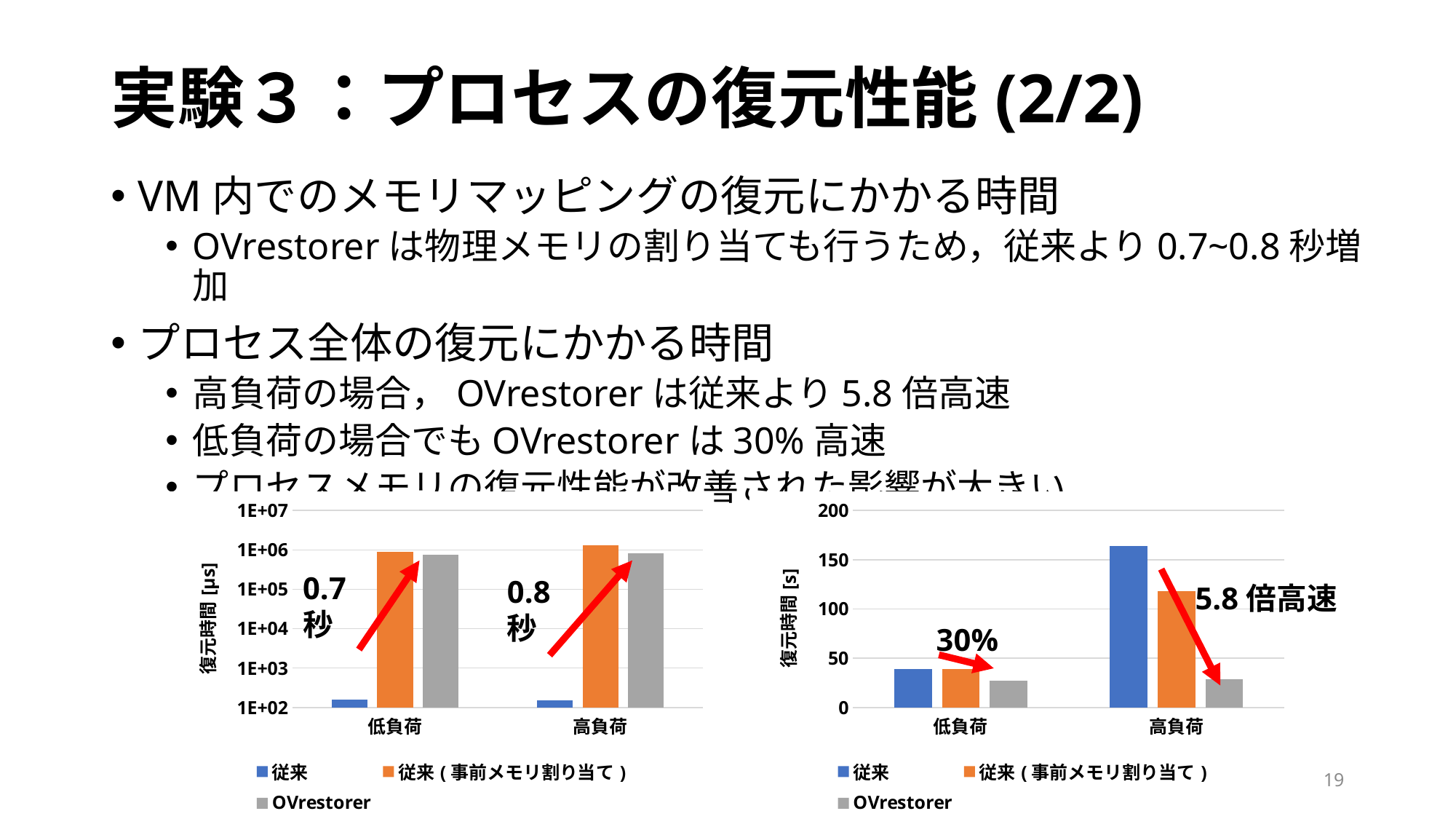
In the right chart (復元時間 [s]), which series has the lowest value at 高負荷? OVrestorer In the left chart (復元時間 [μs]), is the value for 従来 at 低負荷 greater or less than 1E+03? less What kind of chart is the left chart (復元時間 [μs])? bar chart In the right chart (復元時間 [s]), is the value for 従来 at 高負荷 greater or less than 150? greater In the left chart (復元時間 [μs]), which series has the lowest value at 低負荷? 従来 How many categories are shown on the x axis of the right chart (復元時間 [s])? 2 What is the y-axis label of the left chart? 復元時間 [μs] How many series does the legend of the right chart (復元時間 [s]) list? 3 In the right chart (復元時間 [s]), is the value for 従来 ( 事前メモリ割り当て ) at 高負荷 greater or less than 100? greater In the right chart (復元時間 [s]), which is larger at 高負荷: 従来 or OVrestorer? 従来